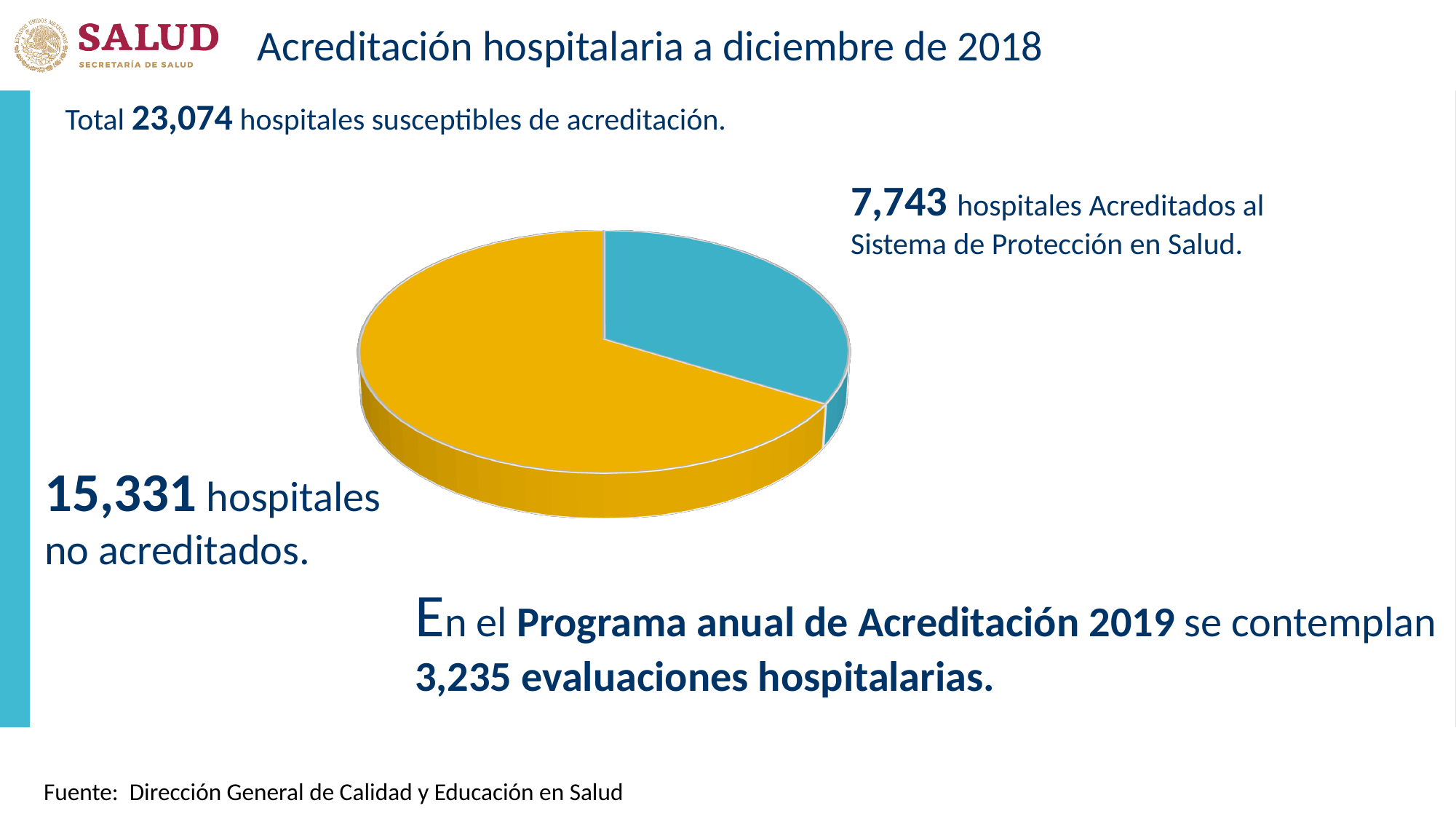
How many slices does the pie chart have? 2 How many hospital evaluations are planned in the Programa anual de Acreditación 2019? 3,235 Is the number of non-accredited hospitals larger or smaller than the number of accredited hospitals? Larger What colour is the slice representing the accredited hospitals? Blue What is the title of the slide containing the pie chart? Acreditación hospitalaria a diciembre de 2018 How many hospitals are accredited to the Sistema de Protección en Salud according to the slide? 7,743 Which group represents the smaller slice of the pie: accredited hospitals or non-accredited hospitals? Accredited hospitals Which group represents the larger slice of the pie: accredited hospitals or non-accredited hospitals? Non-accredited hospitals What is the difference between the number of non-accredited hospitals and the number of accredited hospitals? 7,588 What is the total number of hospitals susceptible to accreditation shown on the slide? 23,074 How many hospitals are not accredited (no acreditados) according to the slide? 15,331 What kind of chart is shown on the slide? Pie chart